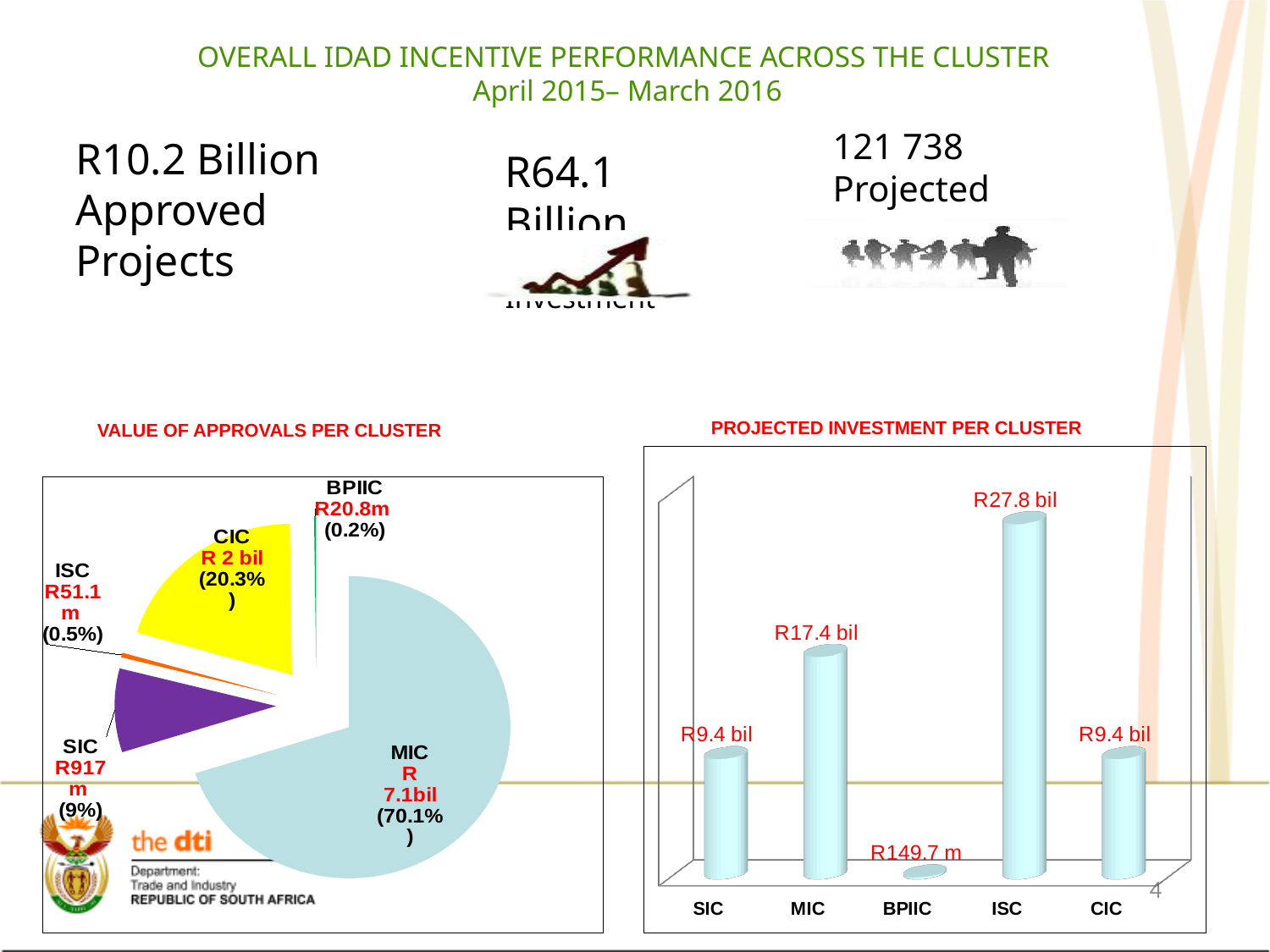
In the VALUE OF APPROVALS PER CLUSTER pie chart, which cluster has the smallest share? BPIIC In the PROJECTED INVESTMENT PER CLUSTER chart, what is the value for MIC? R17.4 bil In the PROJECTED INVESTMENT PER CLUSTER chart, which cluster has the lowest projected investment? BPIIC In the PROJECTED INVESTMENT PER CLUSTER chart, which is larger, MIC or SIC? MIC In the VALUE OF APPROVALS PER CLUSTER pie chart, what share does MIC have? 70.1% What kind of chart is PROJECTED INVESTMENT PER CLUSTER? Bar chart In the PROJECTED INVESTMENT PER CLUSTER chart, what is the value for ISC? R27.8 bil What kind of chart is VALUE OF APPROVALS PER CLUSTER? Pie chart In the VALUE OF APPROVALS PER CLUSTER pie chart, what is the value for CIC? R 2 bil In the PROJECTED INVESTMENT PER CLUSTER chart, what is the value for BPIIC? R149.7 m In the PROJECTED INVESTMENT PER CLUSTER chart, how many clusters are shown on the x axis? 5 In the PROJECTED INVESTMENT PER CLUSTER chart, which cluster has the highest projected investment? ISC